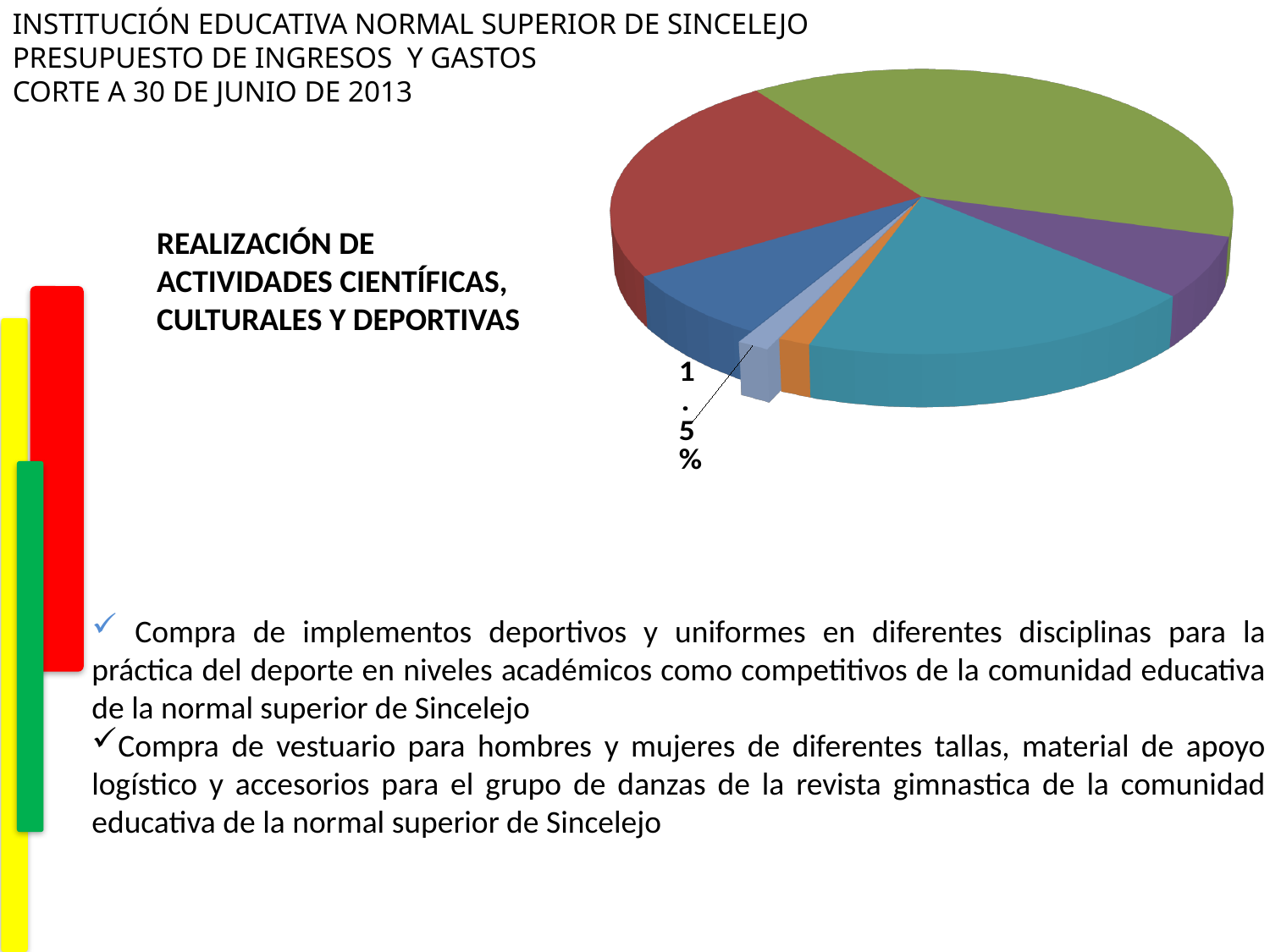
What kind of chart is shown on the slide? pie chart Which colour slice is the largest in the pie chart? green What share of the pie does the exploded light-blue slice represent? 1.5% What percentage is printed on the data label of the exploded (pulled-out) slice of the pie chart? 1.5% Which is larger in the pie chart, the red slice or the dark blue slice? red Which is larger in the pie chart, the green slice or the red slice? green How many data labels are printed on the pie chart? 1 How many slices does the pie chart have? 7 Which is larger in the pie chart, the teal slice or the purple slice? teal Does the pie chart display a legend? No